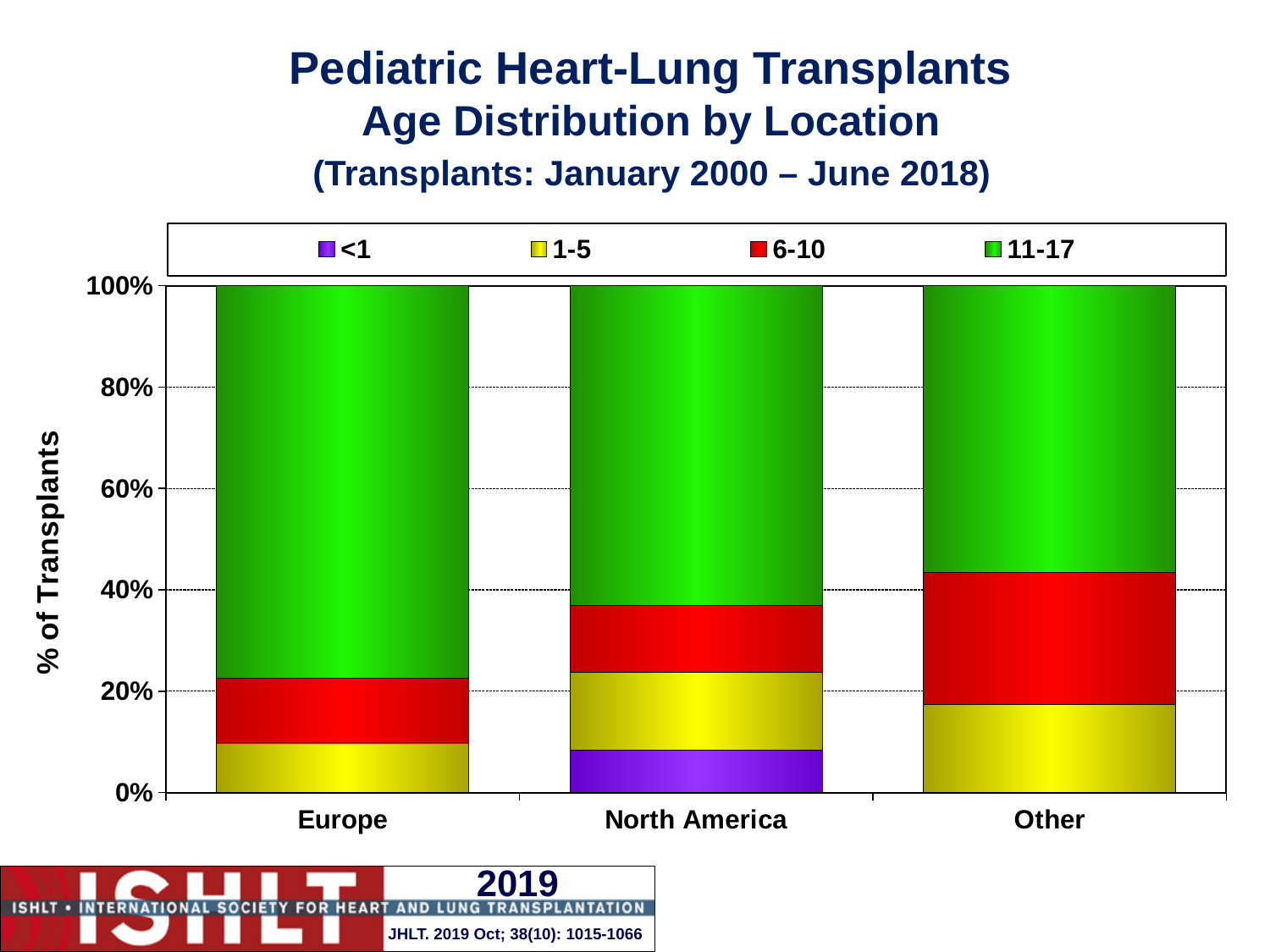
Is the share of the 11-17 age group for Other greater or less than 80%? less What kind of chart is shown on the slide? Stacked bar chart Is the share of the <1 age group for North America greater or less than 20%? less What is the label of the y axis? % of Transplants Which age groups are listed in the legend? <1, 1-5, 6-10, 11-17 How many locations are shown on the x axis? 3 Which has the larger share of the 1-5 age group, Europe or Other? Other How many age groups does the legend list? 4 Which location has the largest share of transplants in the 11-17 age group? Europe Which location is the only one with a visible <1 age group segment? North America Is the share of the 11-17 age group for Europe greater or less than 60%? greater Which location has the largest share of transplants in the 6-10 age group? Other